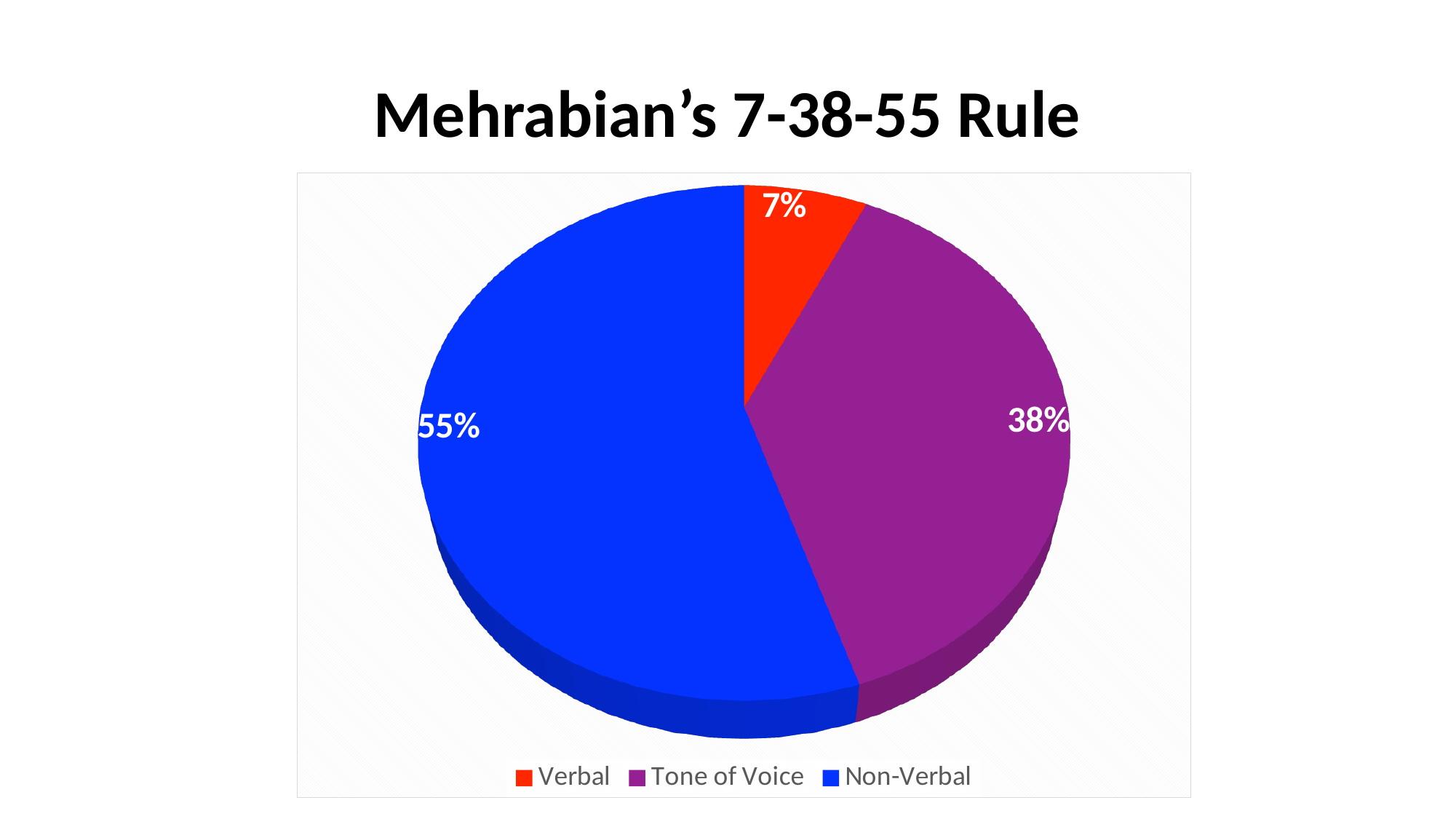
What share of the pie does Tone of Voice account for? 38% What is the difference in percentage points between Non-Verbal and Tone of Voice? 17 Which category has the largest slice of the pie? Non-Verbal Which is larger, the Tone of Voice slice or the Verbal slice? Tone of Voice What is the title of the slide? Mehrabian's 7-38-55 Rule How many slices does the pie chart have? 3 What is the difference in percentage points between Tone of Voice and Verbal? 31 What share of the pie does Non-Verbal account for? 55% What kind of chart is shown on the slide? Pie chart Which category has the smallest slice of the pie? Verbal What colour is the Non-Verbal slice? Blue What share of the pie does Verbal account for? 7%